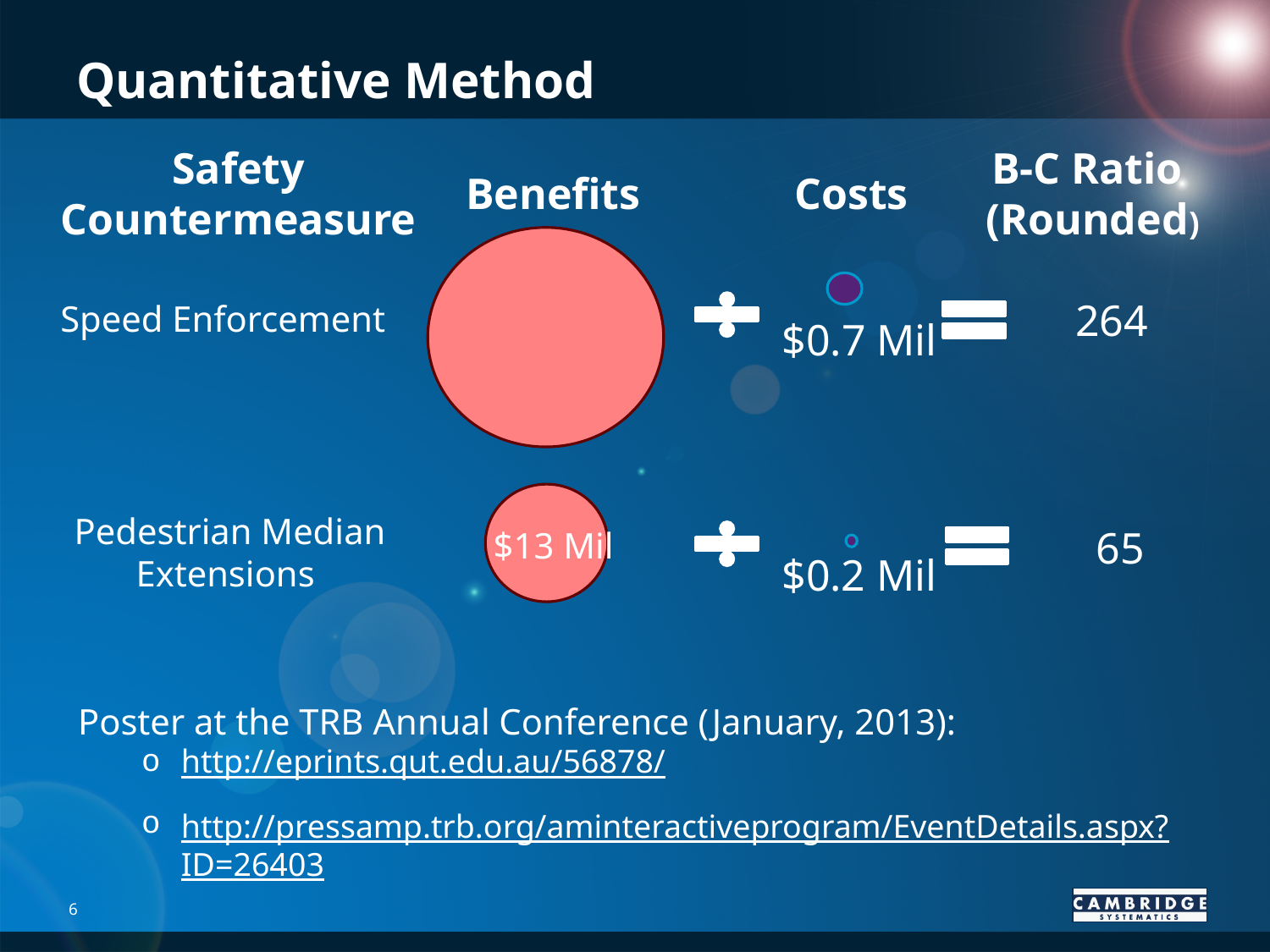
What is the rounded B-C Ratio for Pedestrian Median Extensions? 65 How many safety countermeasures are compared in the diagram? 2 What is the benefit value shown for Pedestrian Median Extensions? $13 Mil What is the rounded B-C Ratio for Speed Enforcement? 264 What is the difference between the B-C Ratios of Speed Enforcement and Pedestrian Median Extensions? 199 Which safety countermeasure has the lower cost? Pedestrian Median Extensions What colour are the benefits circles in the diagram? Red/pink Which safety countermeasure has the larger benefits circle? Speed Enforcement What is the difference between the costs of Speed Enforcement and Pedestrian Median Extensions? $0.5 Mil Which safety countermeasure has the higher B-C Ratio? Speed Enforcement What is the cost shown for Speed Enforcement? $0.7 Mil What is the cost shown for Pedestrian Median Extensions? $0.2 Mil